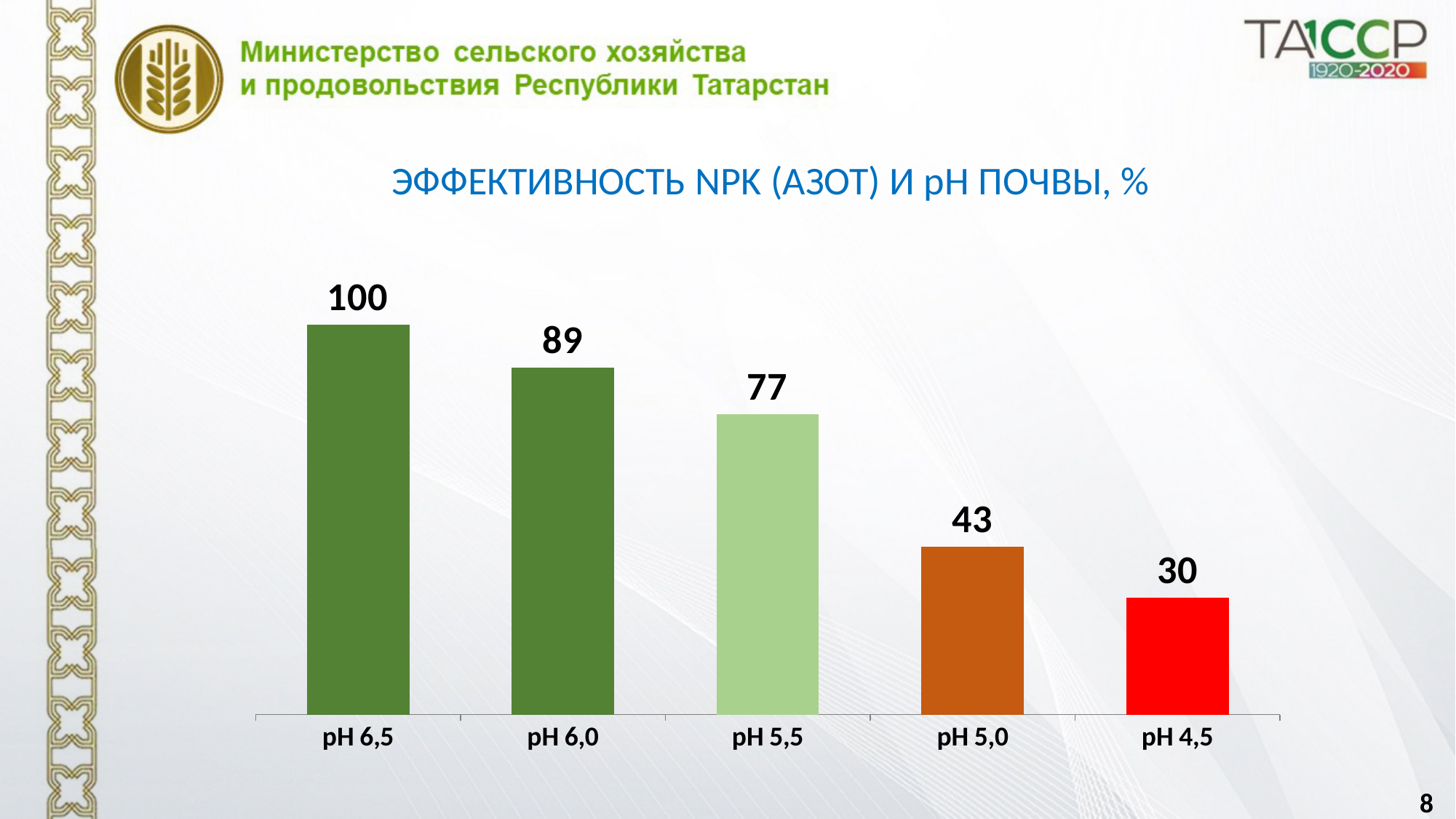
What kind of chart is shown on the slide? bar chart Which is larger, the value for pH 5,5 or the value for pH 5,0? pH 5,5 What is the value for pH 6,5? 100 What is the difference between the values for pH 5,0 and pH 4,5? 13 How many categories are shown on the chart? 5 Which category has the lowest value? pH 4,5 What is the value for pH 5,5? 77 What is the title of the chart? ЭФФЕКТИВНОСТЬ NPK (АЗОТ) И pH ПОЧВЫ, % Do the values rise or fall from left to right along the x axis? fall What is the value for pH 4,5? 30 Which category has the highest value? pH 6,5 What is the difference between the values for pH 6,0 and pH 5,0? 46